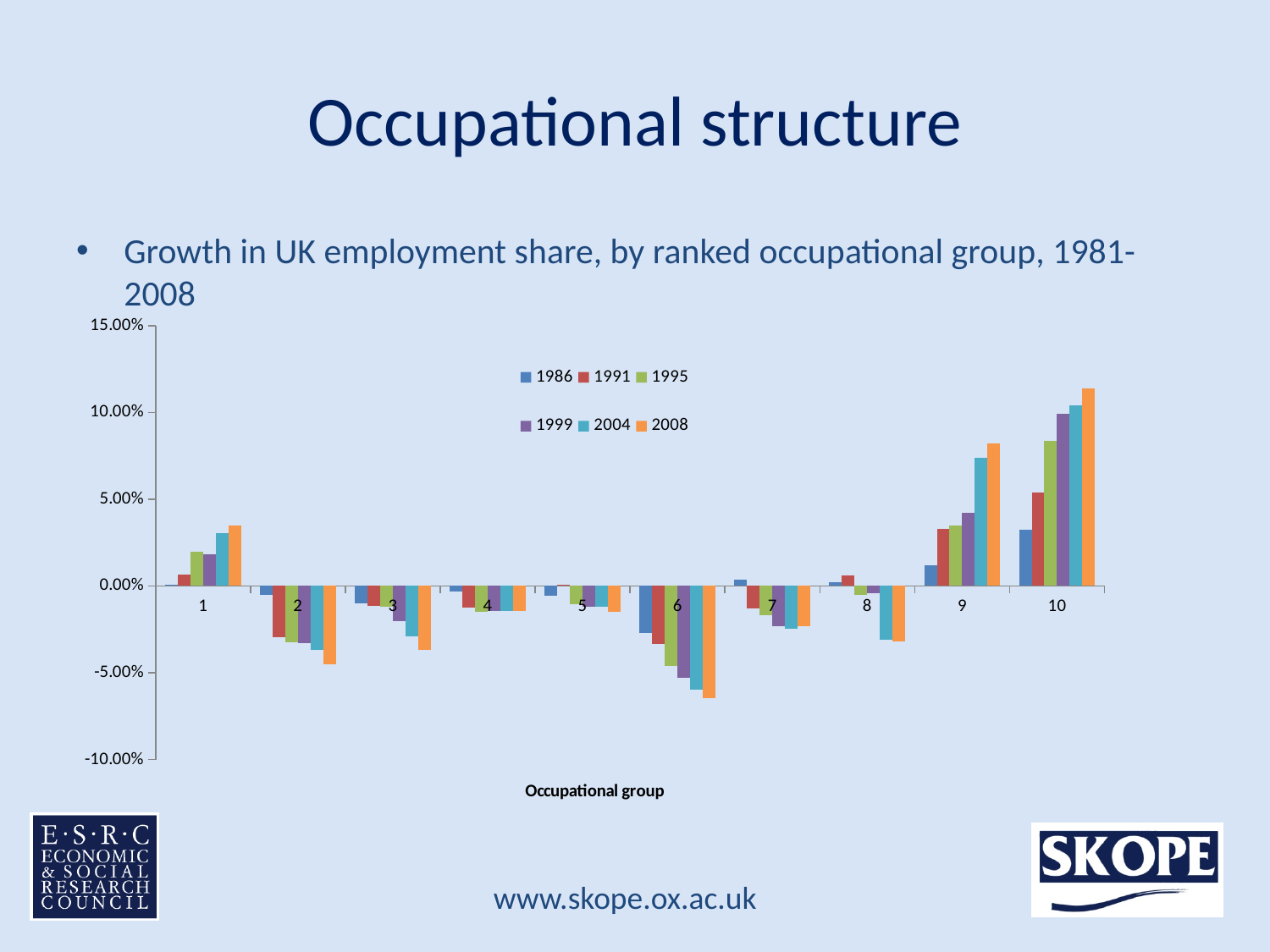
Which is larger for the 2004 series: occupational group 1 or occupational group 2? 1 Is the 2008 value for occupational group 6 greater or less than -5.00%? less Which occupational group has the highest value for the 2008 series? 10 Is the 2008 value for occupational group 10 greater or less than 10.00%? greater Which is larger for the 2008 series: occupational group 9 or occupational group 10? 10 For occupational group 10, do the values rise or fall from the 1986 series to the 2008 series? rise What kind of chart is shown on the slide? bar chart Is the 2008 value for occupational group 9 greater or less than 5.00%? greater Which occupational group has the lowest value for the 2008 series? 6 How many occupational groups are shown on the x axis? 10 How many series does the legend list? 6 What is the title of the x axis? Occupational group